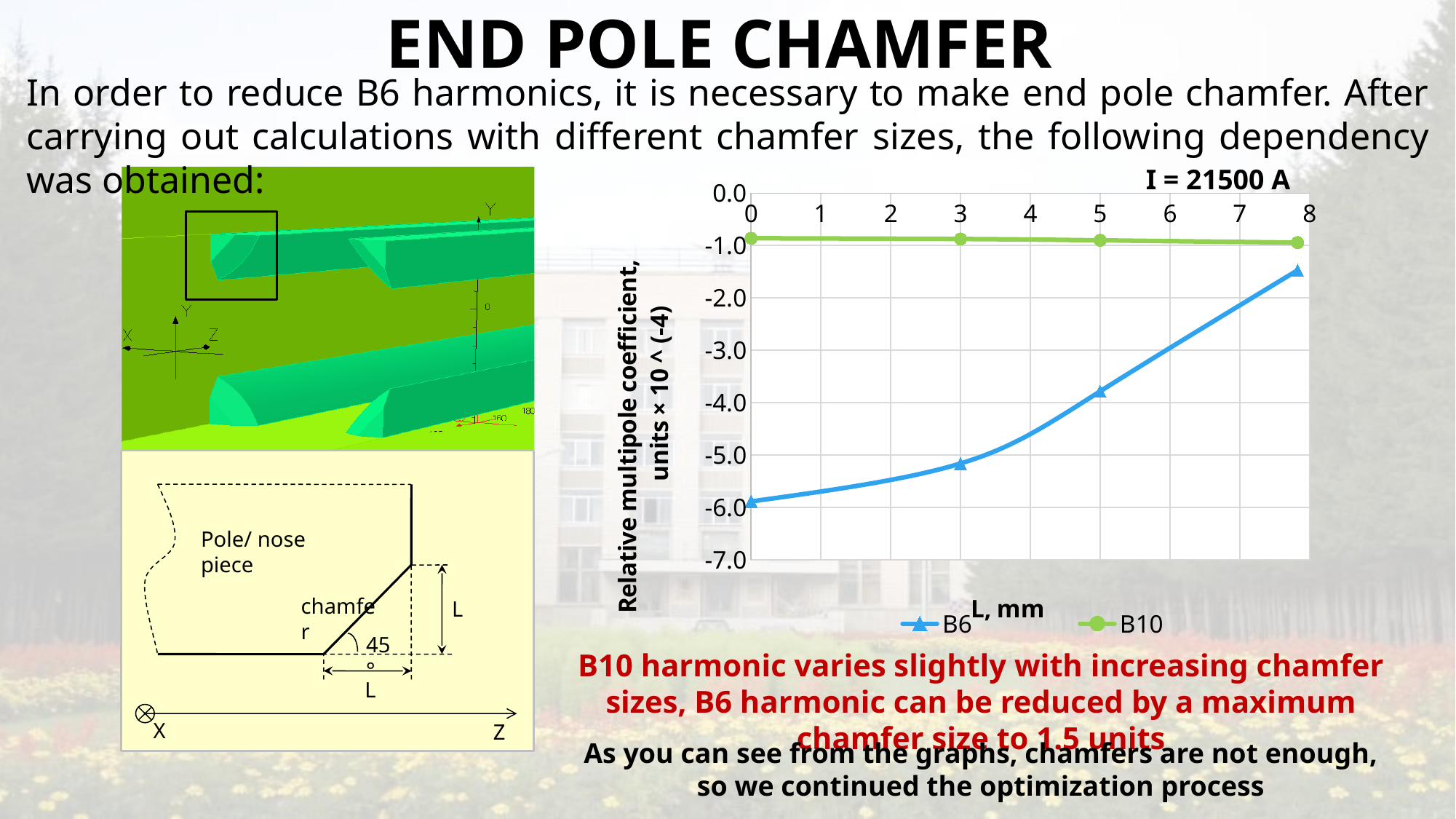
Is the B6 value at L = 5 mm greater or less than -3.0? less At which value of L is the B6 series lowest? 0 Which series are listed in the chart legend? B6 and B10 Is the B6 value at L = 8 mm greater or less than -2.0? greater Is the B6 value at L = 0 mm greater or less than -5.0? less What is the x-axis title of the chart? L, mm What kind of chart is shown on the slide? line chart How many data points are plotted for the B6 series? 4 How many series does the chart legend list? 2 Does the B6 series rise or fall as L increases from 0 to 8 mm? rise At L = 3 mm, which series has the larger value, B6 or B10? B10